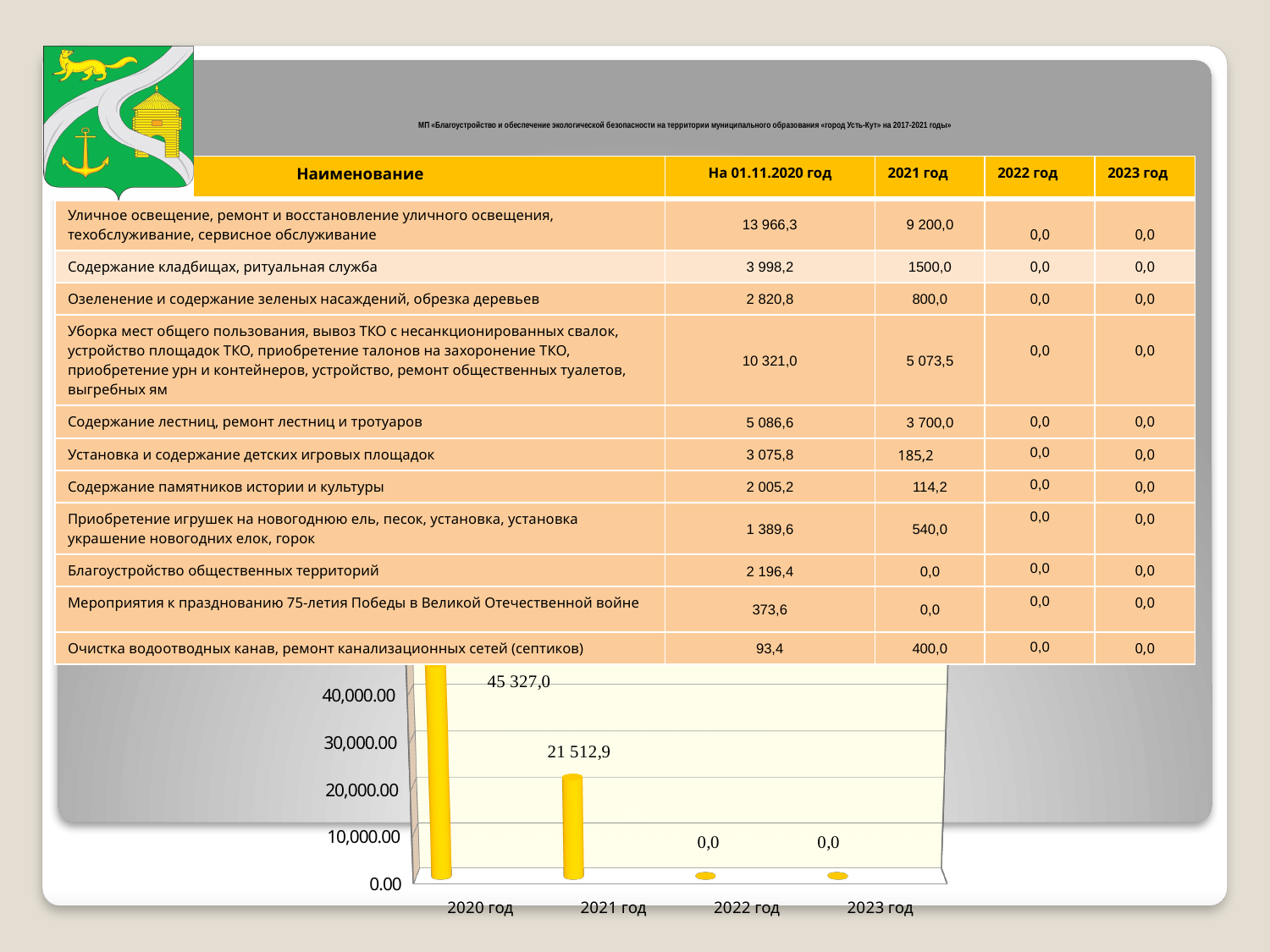
How many categories are shown on the x axis of the bar chart at the bottom of the slide? 4 In the bar chart at the bottom of the slide, do the values rise or fall from 2020 год to 2023 год? fall What is the value for 2022 год in the bar chart at the bottom of the slide? 0,0 Which category has the highest value in the bar chart at the bottom of the slide? 2020 год What is the value for 2020 год in the bar chart at the bottom of the slide? 45 327,0 In the bar chart at the bottom of the slide, which is larger: the value for 2020 год or the value for 2021 год? 2020 год What is the value for 2023 год in the bar chart at the bottom of the slide? 0,0 What is the value for 2021 год in the bar chart at the bottom of the slide? 21 512,9 In the bar chart at the bottom of the slide, is the value for 2021 год greater or less than 20,000.00? greater In the bar chart at the bottom of the slide, is the value for 2020 год greater or less than 40,000.00? greater What is the highest tick label shown on the y axis of the bar chart at the bottom of the slide? 40,000.00 What kind of chart is shown at the bottom of the slide? bar chart